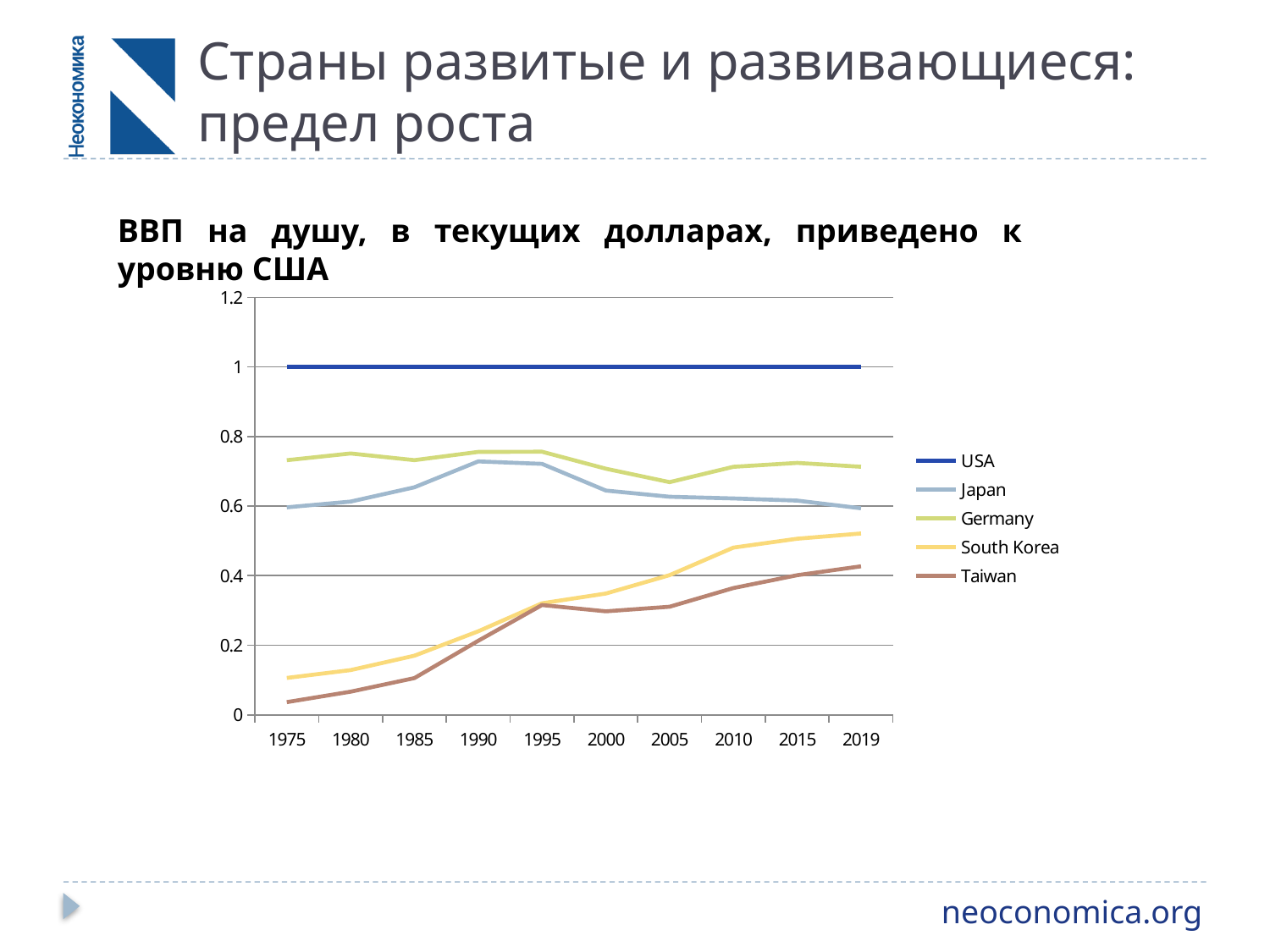
What is the value for USA across all years? 1 Does the value for South Korea rise or fall from 1975 to 2019? rise How many series does the legend list? 5 Is the value for Japan in 1990 greater or less than 0.6? greater Which series is listed last in the legend? Taiwan Which is higher in 2019, Germany or Japan? Germany Is the value for South Korea in 1975 greater or less than 0.2? less Is the value for Taiwan in 2019 greater or less than 0.4? greater How many years are marked along the x axis? 10 Which series has the lowest value in 1975? Taiwan Which is higher in 2019, South Korea or Taiwan? South Korea What kind of chart is shown on the slide? line chart